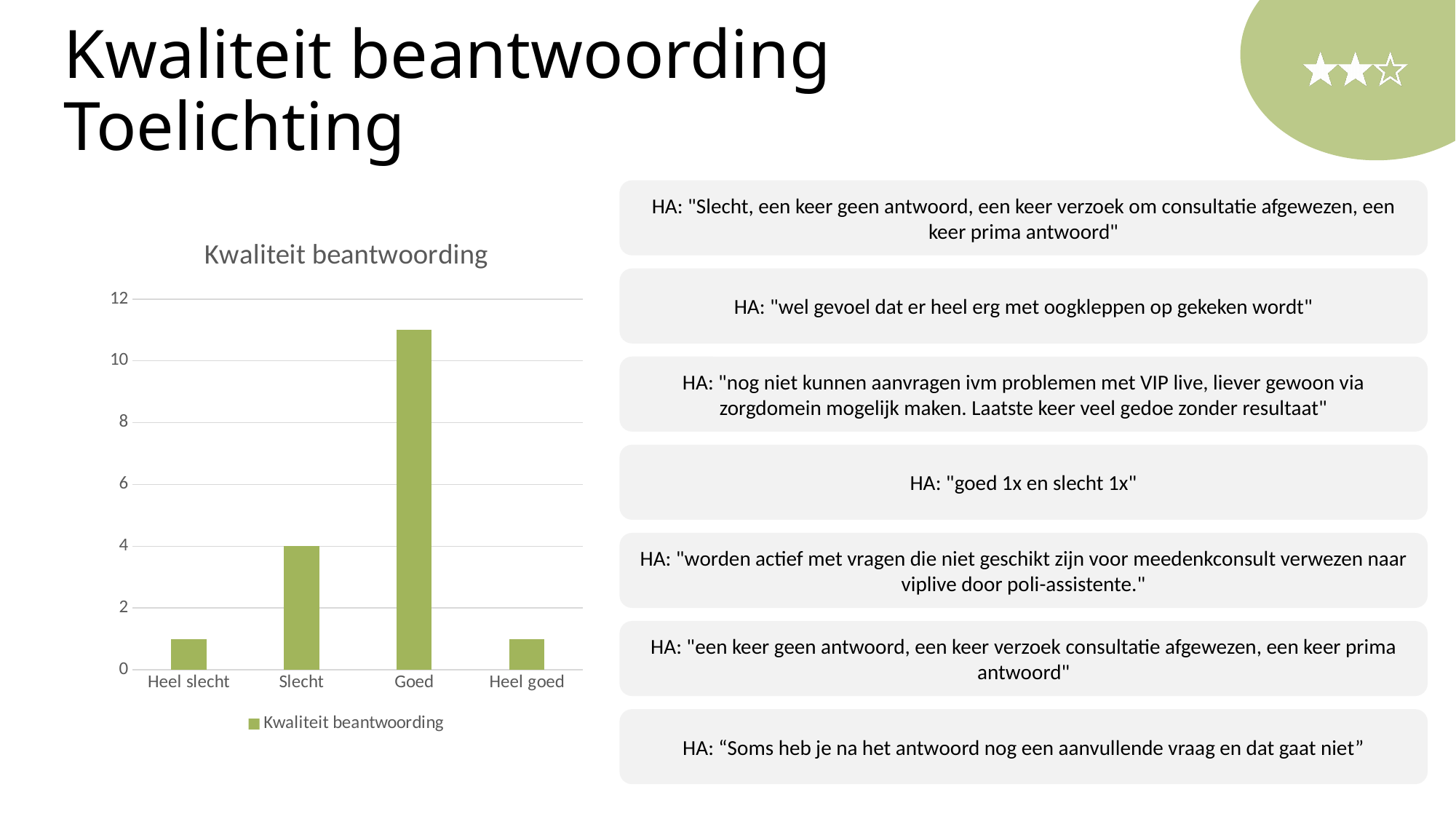
What kind of chart is shown on the slide? bar chart What is the value for Slecht in the chart? 4 What is the name of the series shown in the chart legend? Kwaliteit beantwoording Which is larger in the chart, the value for Slecht or the value for Heel goed? Slecht What is the title of the chart? Kwaliteit beantwoording How many series does the chart legend list? 1 Which is larger in the chart, the value for Goed or the value for Slecht? Goed Is the value for Goed greater or less than 10? greater Which category has the highest value in the chart? Goed Is the value for Heel slecht greater or less than 2? less Is the value for Heel goed greater or less than 2? less How many categories are shown on the x axis of the chart? 4